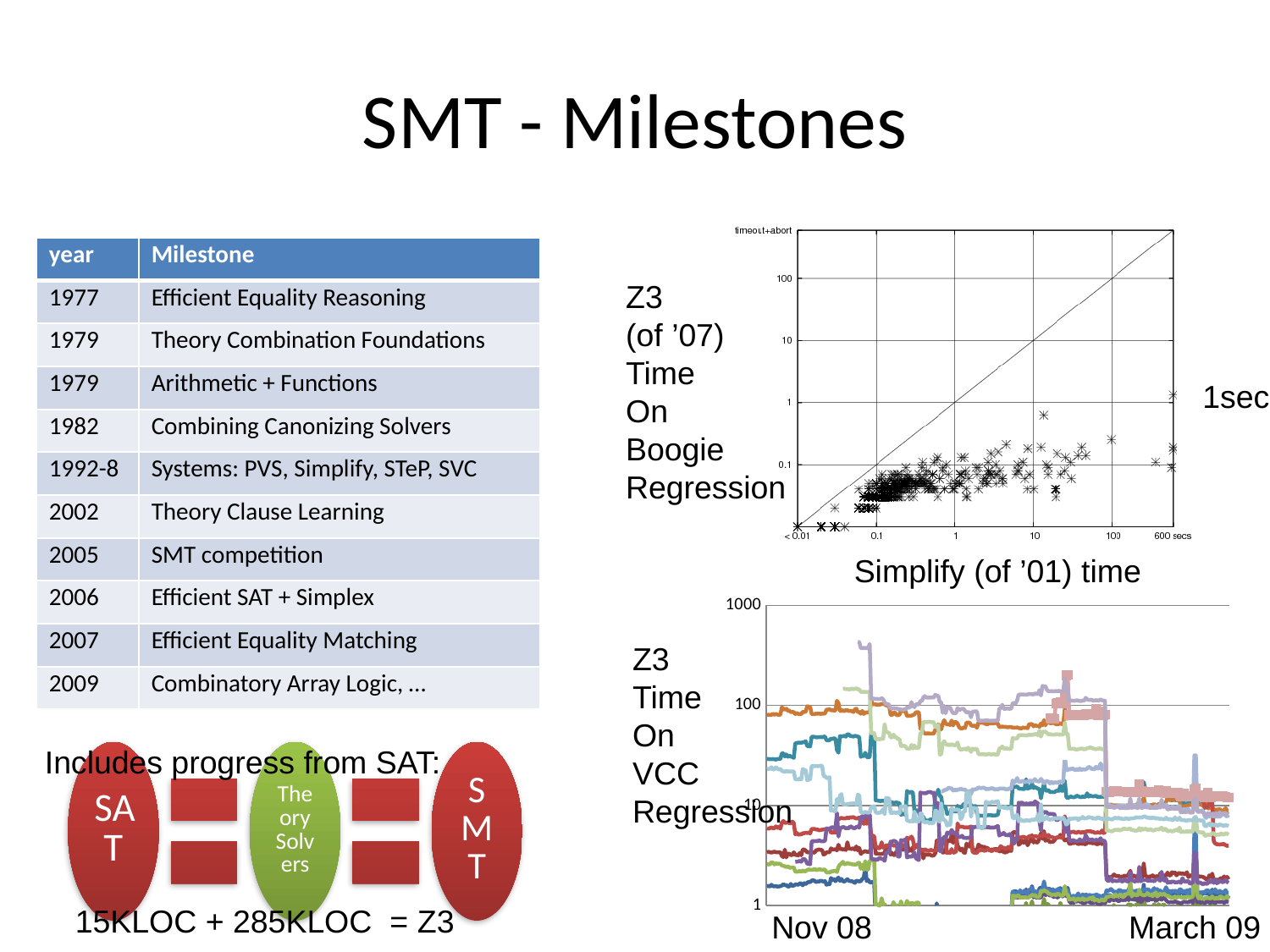
In the upper scatter plot, are most of the plotted points above or below the diagonal line? below In the upper scatter plot, what is labelled on the x axis? Simplify (of '01) time In the lower line chart, do the Z3 times on VCC regression generally rise or fall from Nov 08 to March 09? fall In the lower line chart, what are the first and last dates labelled on the x axis? Nov 08 and March 09 What kind of chart is the upper chart comparing Z3 (of '07) time with Simplify (of '01) time? scatter plot What kind of chart is the lower chart showing Z3 time on VCC regression? line chart In the upper scatter plot, is the largest x-axis tick value greater or less than 100? greater In the lower line chart, what is the highest value shown on the y axis? 1000